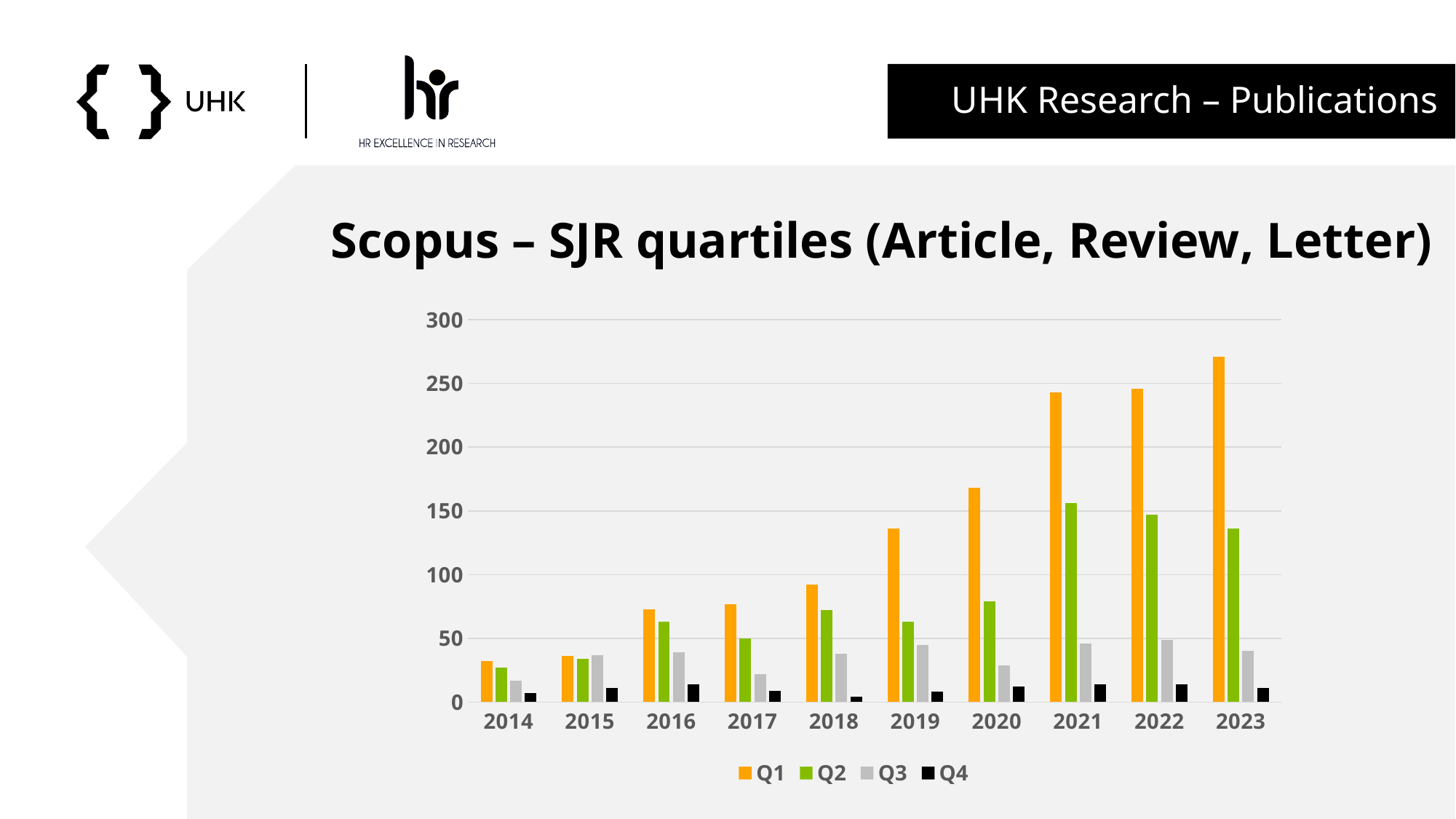
Is the Q2 value for 2021 greater or less than 100? greater Is the Q1 value for 2023 greater or less than 250? greater What is the title of the chart? Scopus – SJR quartiles (Article, Review, Letter) What kind of chart is shown on the slide? bar chart Is the Q1 value for 2019 greater or less than 150? less In 2023, which is larger, the Q1 value or the Q2 value? Q1 How many series does the legend list? 4 How many years are shown on the x axis? 10 Do the Q1 values generally rise or fall from 2014 to 2023? rise In which year is the Q1 value highest? 2023 In which year is the Q1 value lowest? 2014